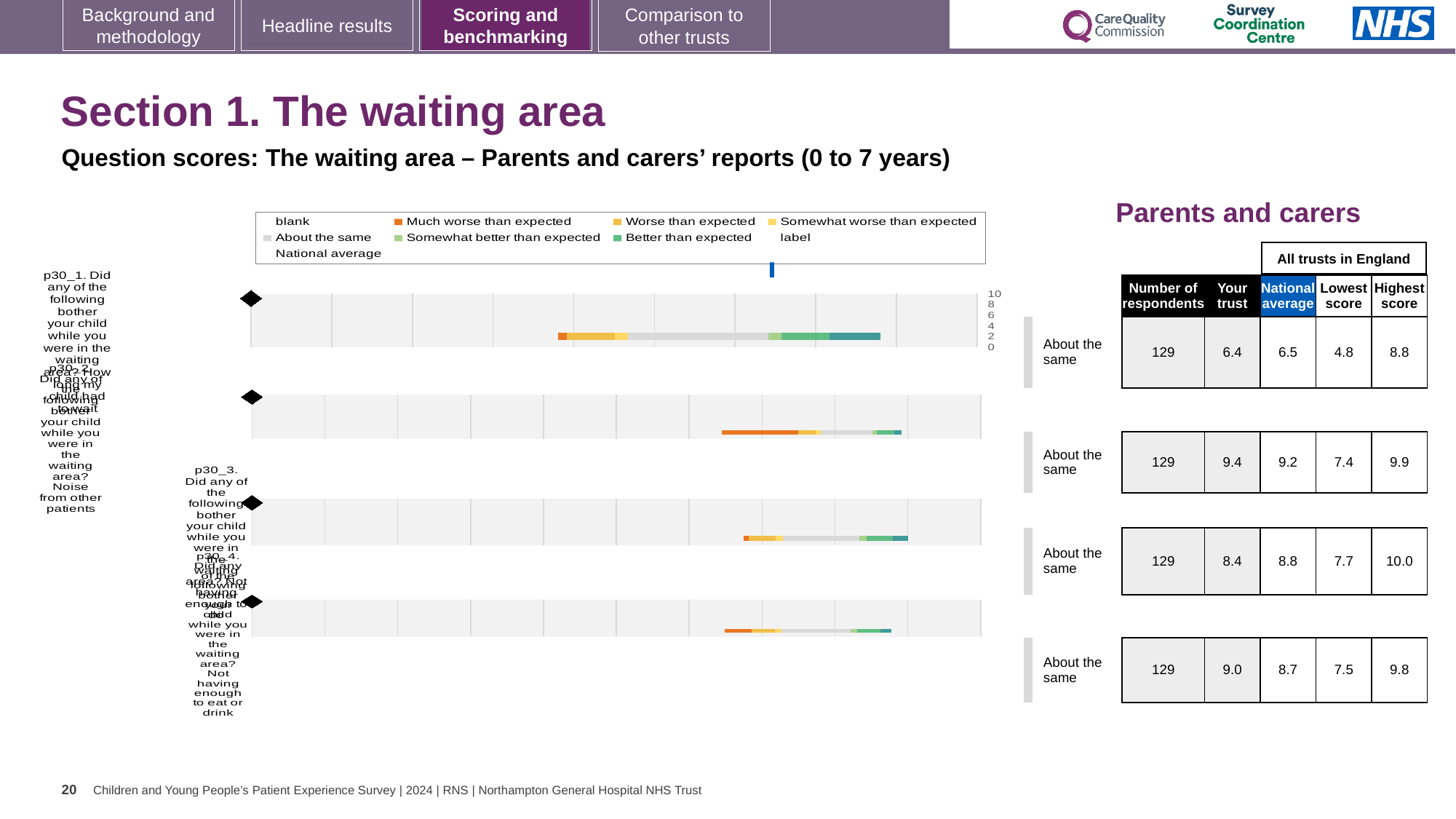
In the table beside the chart, what is the 'Your trust' score for the first row (p30_1)? 6.4 How many horizontal bars (question rows) does the chart contain? 4 In the table beside the chart, how many respondents are listed for each row? 129 In the table beside the chart, what is the Highest score for the second row (p30_2)? 9.9 What benchmark label is shown beside each of the four bars in the chart? About the same In the table beside the chart, what is the National average for the first row (p30_1)? 6.5 Which row in the table has the highest 'Your trust' score? the second row (p30_2), 9.4 For the second row (p30_2), which is larger: the 'Your trust' score or the National average? Your trust In the chart legend, which colour represents 'Much worse than expected'? orange Which row in the table has the lowest 'Your trust' score? the first row (p30_1), 6.4 What kind of chart is shown on the slide? bar chart For the third row (p30_3), what is the difference between the National average (8.8) and the 'Your trust' score (8.4)? 0.4